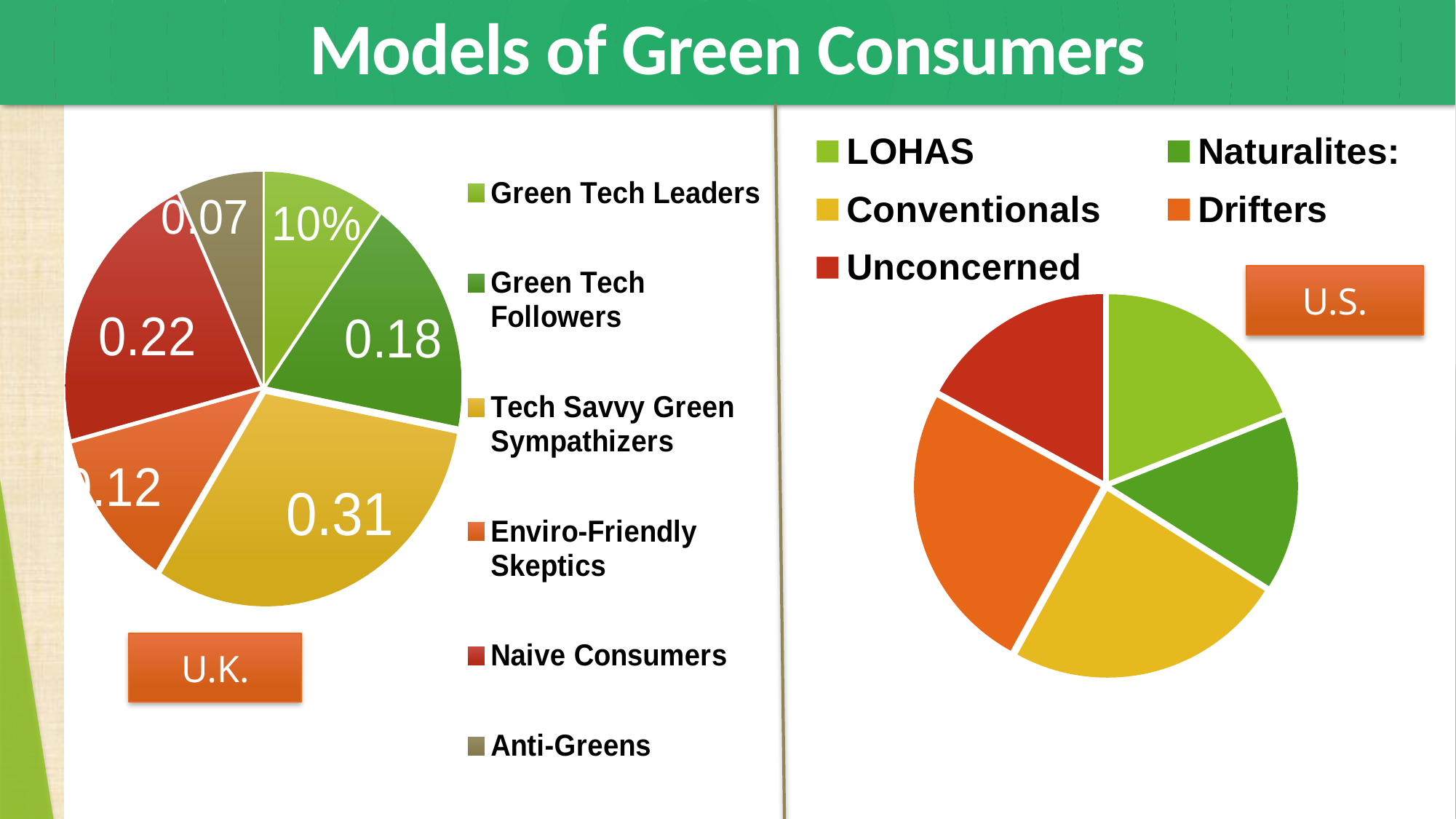
On the U.K. pie chart, what value is shown for Tech Savvy Green Sympathizers? 0.31 On the U.K. pie chart, which category has the largest slice? Tech Savvy Green Sympathizers On the U.K. pie chart, which is larger: Naive Consumers or Enviro-Friendly Skeptics? Naive Consumers On the U.K. pie chart, what value is shown for Naive Consumers? 0.22 How many categories does the U.S. pie chart's legend list? 5 On the U.S. pie chart, which is larger: Conventionals or Naturalites? Conventionals On the U.K. pie chart, what value is shown for Anti-Greens? 0.07 How many categories does the U.K. pie chart show? 6 What type of chart is used for the U.S. data on the right of the slide? Pie chart On the U.K. pie chart, what is the difference between the values for Tech Savvy Green Sympathizers and Green Tech Followers? 0.13 On the U.K. pie chart, what value is shown for Green Tech Leaders? 10% On the U.K. pie chart, which category has the smallest slice? Anti-Greens